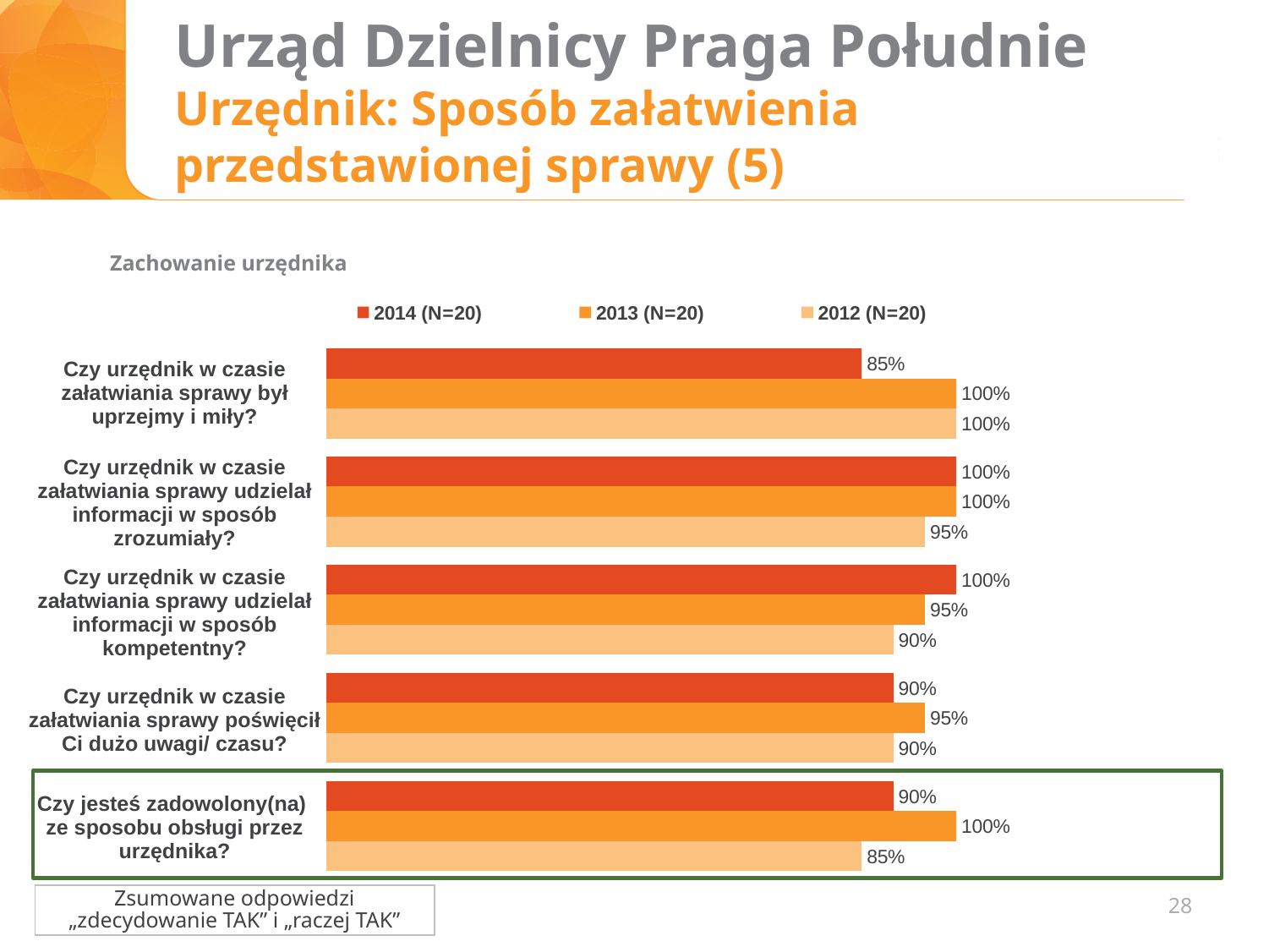
What is the 2013 (N=20) value for "Czy jesteś zadowolony(na) ze sposobu obsługi przez urzędnika?"? 100% How many question categories are plotted in the chart? 5 What is the difference between the 2013 and 2014 values for "Czy urzędnik w czasie załatwiania sprawy był uprzejmy i miły?"? 15% What is the 2014 (N=20) value for "Czy urzędnik w czasie załatwiania sprawy był uprzejmy i miły?"? 85% What is the 2012 (N=20) value for "Czy urzędnik w czasie załatwiania sprawy udzielał informacji w sposób zrozumiały?"? 95% How many series does the legend list? 3 For "Czy urzędnik w czasie załatwiania sprawy udzielał informacji w sposób kompetentny?", which is larger: the 2014 value or the 2012 value? 2014 (N=20) What is the 2012 (N=20) value for "Czy urzędnik w czasie załatwiania sprawy udzielał informacji w sposób kompetentny?"? 90% What kind of chart is shown on the slide? bar chart Which year has the highest value for "Czy urzędnik w czasie załatwiania sprawy poświęcił Ci dużo uwagi/ czasu?"? 2013 (N=20) What is the title shown above the chart? Zachowanie urzędnika Which year has the lowest value for "Czy jesteś zadowolony(na) ze sposobu obsługi przez urzędnika?"? 2012 (N=20)